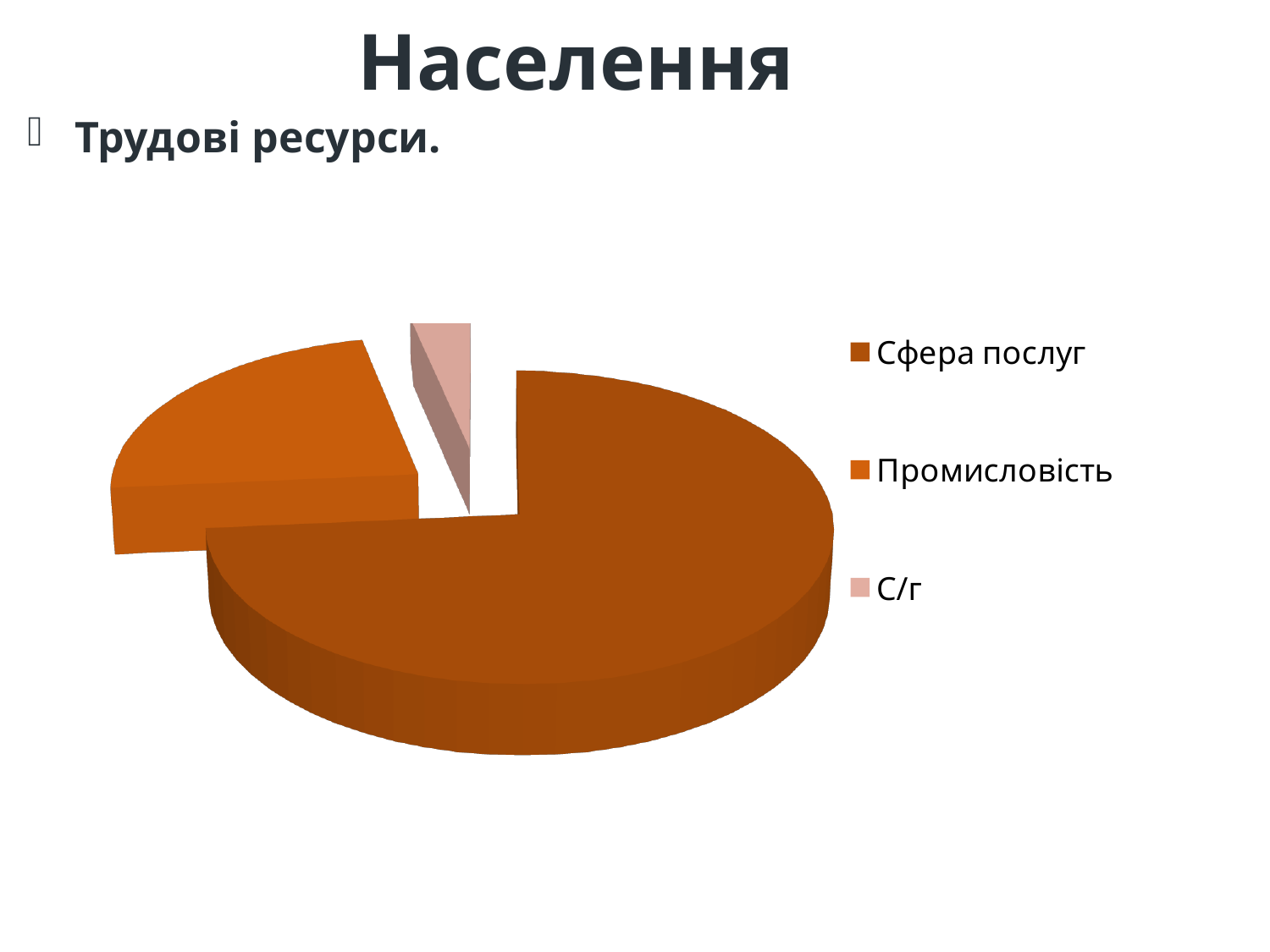
Which category has the largest slice in the pie chart? Сфера послуг How many slices does the pie chart have? 3 Which legend entry is listed first in the pie chart's legend? Сфера послуг Does the Сфера послуг slice take up more or less than half of the pie chart? more What colour is the С/г slice in the pie chart? light pink Which slice is larger in the pie chart, Сфера послуг or Промисловість? Сфера послуг Which slice is larger in the pie chart, Промисловість or С/г? Промисловість Which category has the smallest slice in the pie chart? С/г How many entries does the legend of the pie chart list? 3 What kind of chart is shown on the slide? pie chart